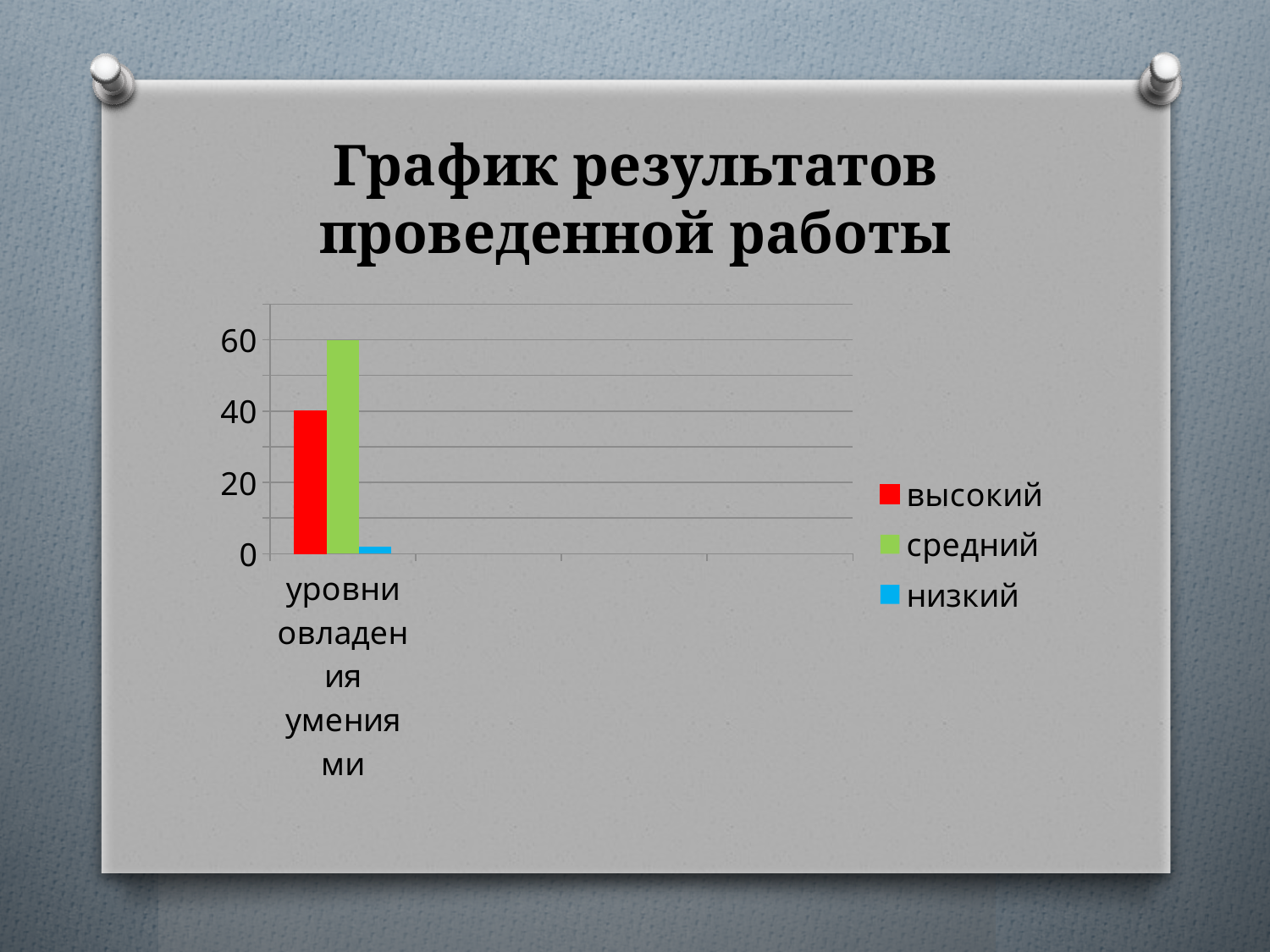
What is the value for the series "высокий"? 40 How many categories are shown on the x axis? 1 How many series does the legend list? 3 What is the difference between the values for "средний" and "высокий"? 20 What is the value for the series "средний"? 60 What colour represents the series "средний" in the legend? green What is the title of the slide? График результатов проведенной работы What kind of chart is shown on the slide? bar chart Is the value for "низкий" greater or less than 20? less Which series has the highest value? средний Which is larger, the value for "высокий" or the value for "низкий"? высокий Which series has the lowest value? низкий